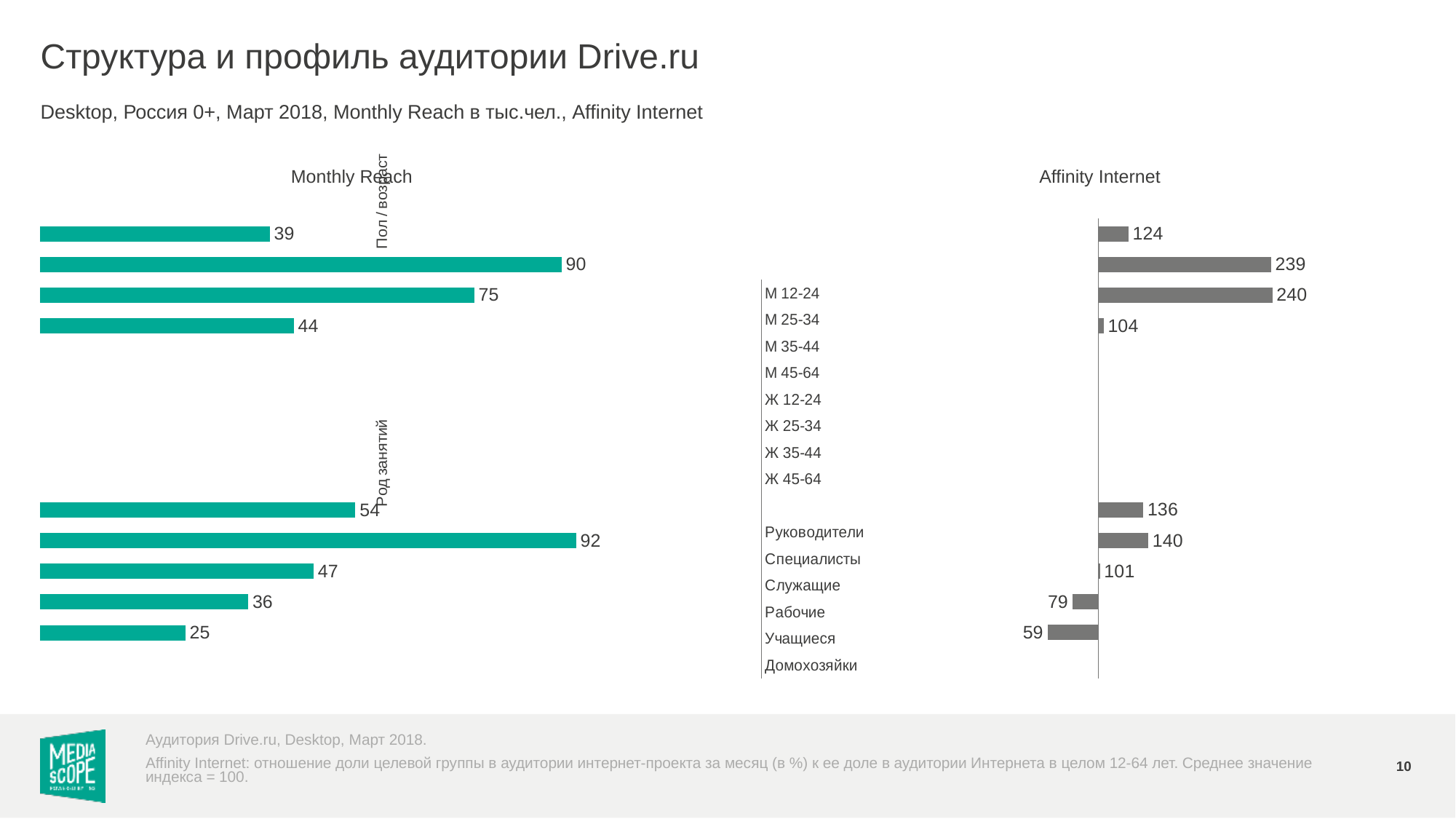
How many bars are plotted in the Monthly Reach chart? 9 What is the title of the chart on the right side of the slide? Affinity Internet In the Monthly Reach chart, what is the value of the bottom bar? 25 In the Affinity Internet chart, what is the lowest value shown? 59 In the Affinity Internet chart, how many bars have a value below 100? 2 In the Monthly Reach chart, what is the lowest value shown? 25 What kind of chart is the Monthly Reach chart? bar chart In the Monthly Reach chart, what is the difference between the highest value (92) and the lowest value (25)? 67 In the Affinity Internet chart, what is the value of the topmost bar? 124 In the Affinity Internet chart, what is the highest value shown? 240 In the Monthly Reach chart, what is the highest value shown? 92 In the Monthly Reach chart, what is the value of the topmost bar? 39